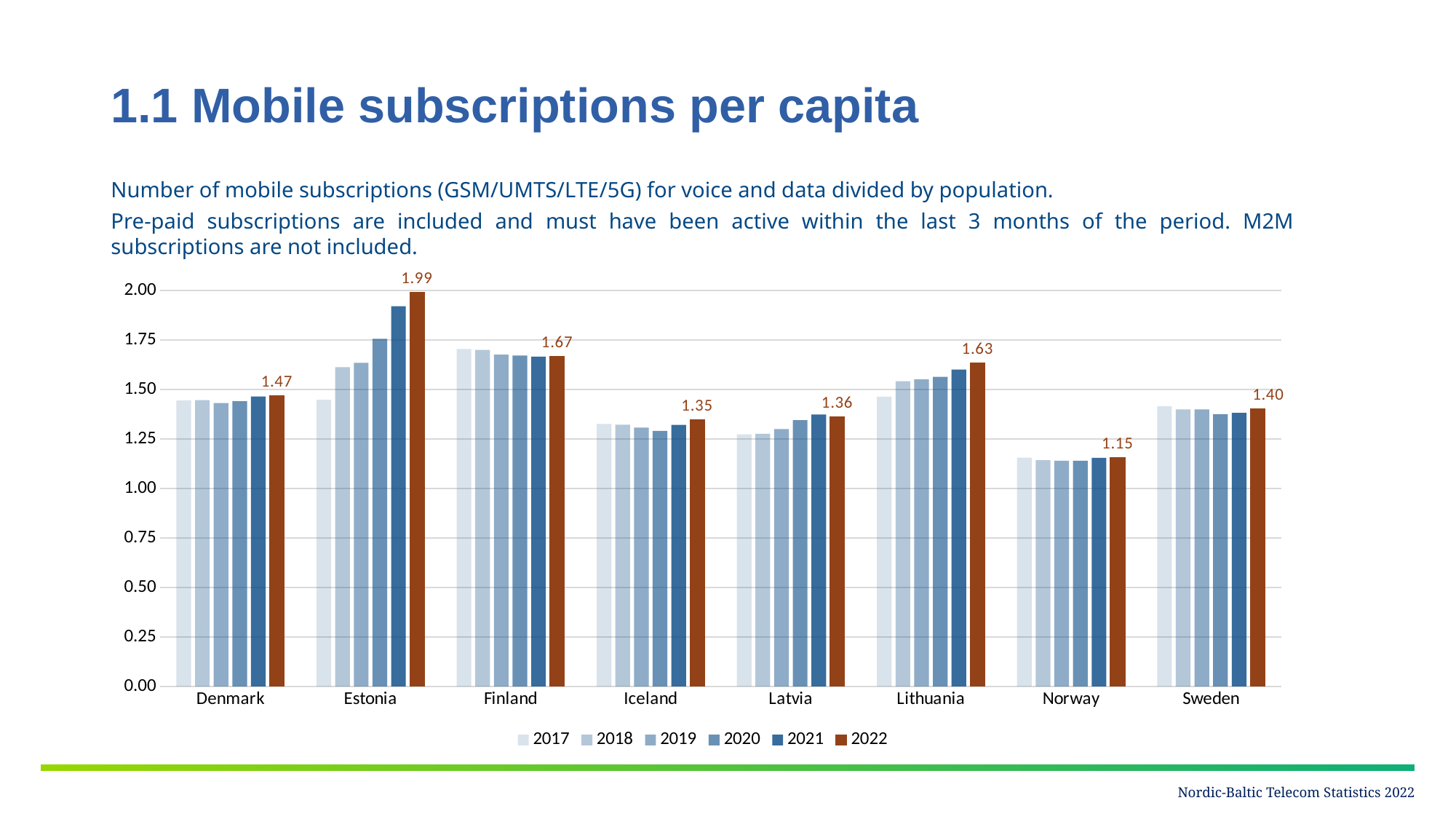
What is the 2022 value for Lithuania? 1.63 Is the 2021 value for Estonia greater or less than 1.75? greater Which country has the highest 2022 value? Estonia What kind of chart is shown? bar chart How many countries are shown on the x axis? 8 What is the 2022 value for Estonia? 1.99 Is the 2017 value for Estonia greater or less than 1.50? less What is the 2022 value for Norway? 1.15 How many series does the legend list? 6 Which has the larger 2022 value, Finland or Sweden? Finland Which country has the lowest 2022 value? Norway What is the difference between the 2022 values for Estonia and Norway? 0.84